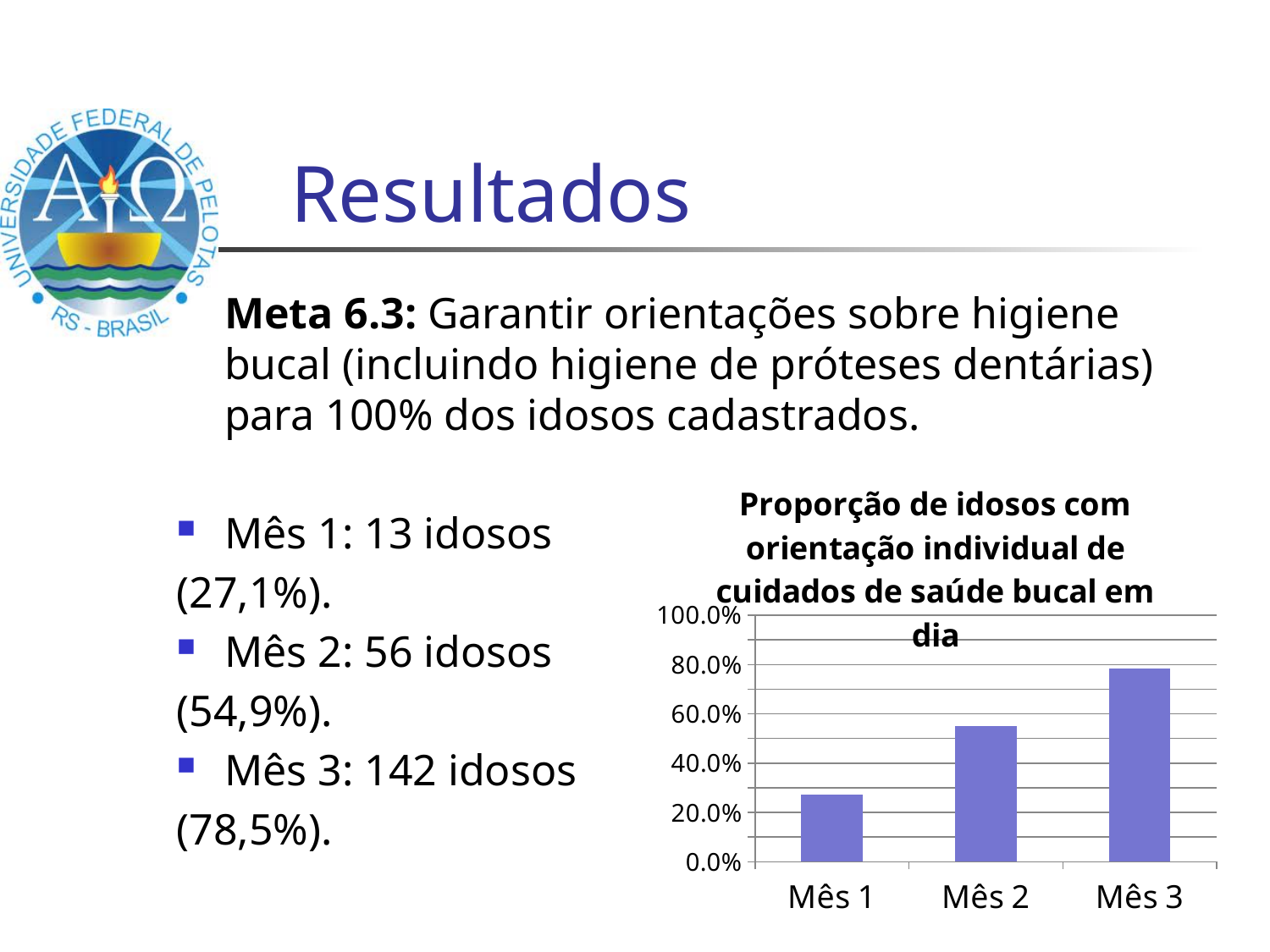
Which is larger, the value for Mês 2 or the value for Mês 3? Mês 3 What is the maximum value shown on the y axis of the chart? 100.0% Do the values rise or fall from Mês 1 to Mês 3? rise What type of chart is shown on the slide? bar chart How many categories are shown on the x axis of the chart? 3 Is the value for Mês 1 greater or less than 40.0%? less Which month has the highest bar in the chart? Mês 3 What is the title of the chart? Proporção de idosos com orientação individual de cuidados de saúde bucal em dia Is the value for Mês 3 greater or less than 60.0%? greater Which month has the lowest bar in the chart? Mês 1 Is the value for Mês 2 greater or less than 40.0%? greater